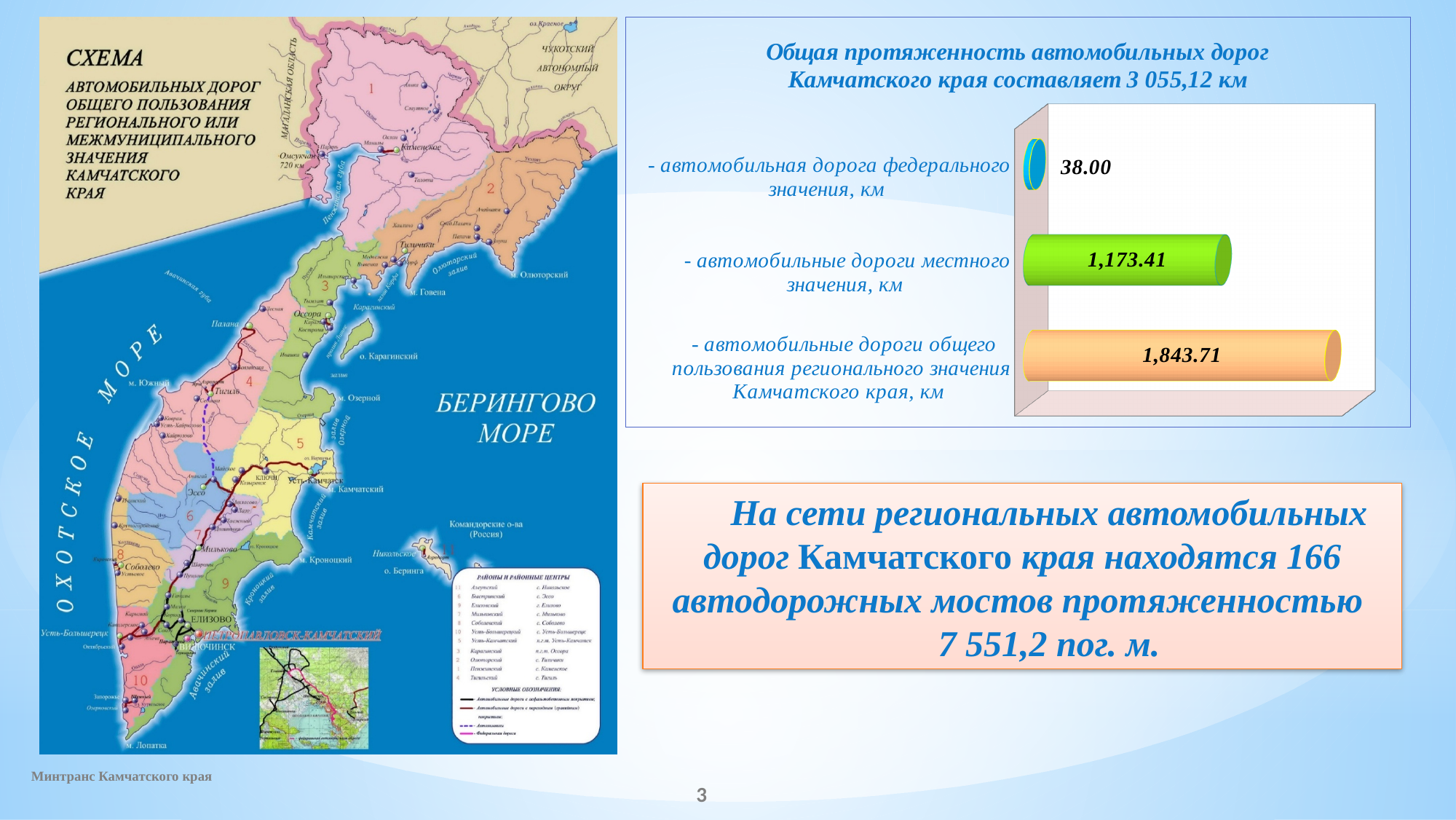
What kind of chart is shown on the slide? bar chart Which road category has the lowest value in the chart? автомобильная дорога федерального значения Which road category has the highest value in the chart? автомобильные дороги общего пользования регионального значения What is the value shown for federal roads (автомобильная дорога федерального значения), in km? 38.00 What is the value shown for regional public roads (автомобильные дороги общего пользования регионального значения), in km? 1,843.71 What is the difference between the local roads value and the federal roads value? 1,135.41 What is the sum of the three bar values in the chart? 3,055.12 Which is larger: the value for local roads or the value for federal roads? local roads (автомобильные дороги местного значения) How many categories (bars) does the chart show? 3 What total road length does the chart title state for Kamchatka Krai? 3 055,12 км What is the value shown for local roads (автомобильные дороги местного значения), in km? 1,173.41 What is the difference between the regional roads value and the local roads value? 670.30